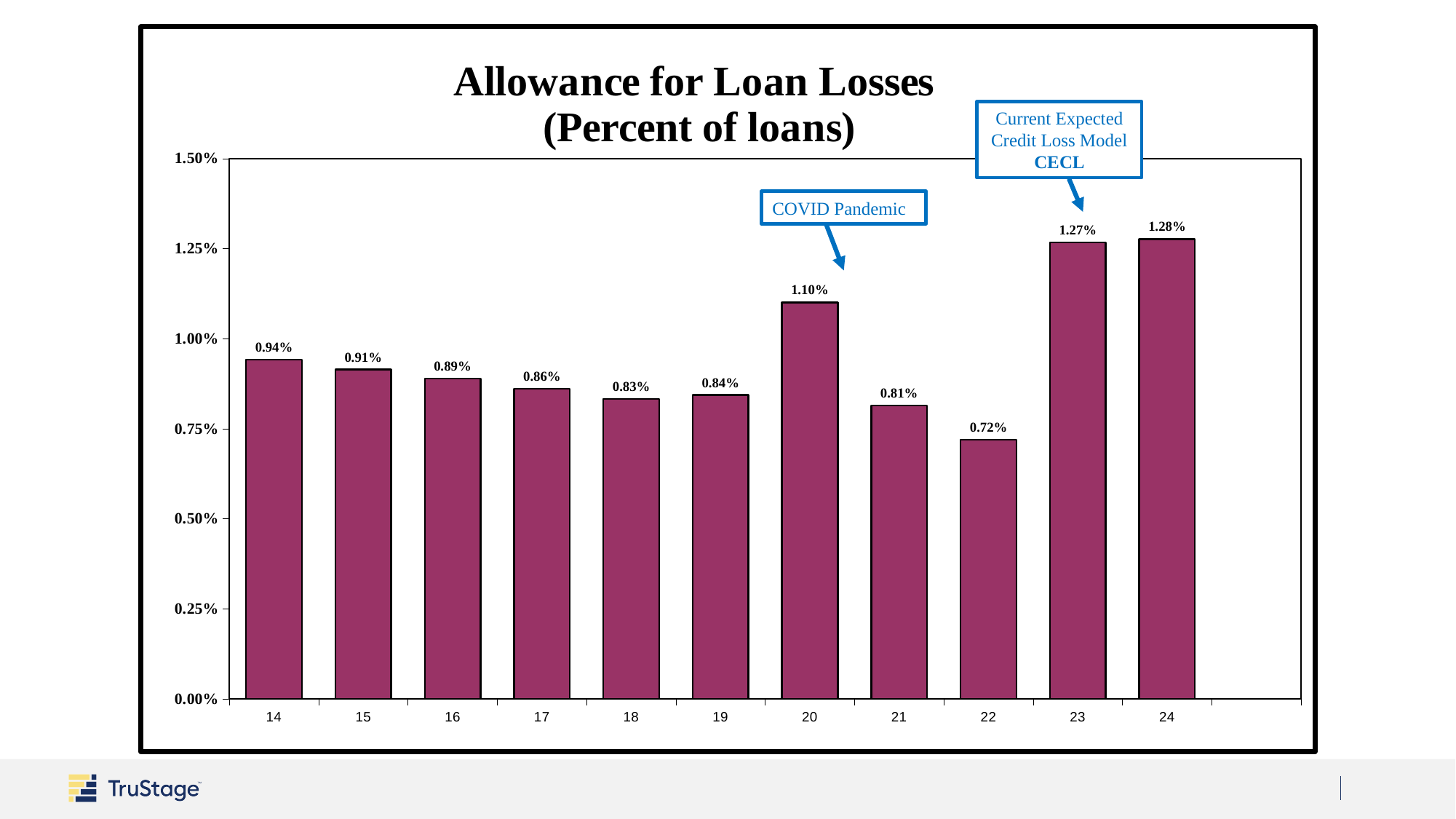
Do the values rise or fall from 14 to 18? Fall Which event does the callout above the bar for 20 label? COVID Pandemic Which year has the highest allowance for loan losses? 24 Is the value for 19 greater or less than 1.00%? less How many years are shown on the x axis? 11 What is the allowance for loan losses in 14? 0.94% Which year has the lowest allowance for loan losses? 22 What is the allowance for loan losses in 22? 0.72% Which year has a higher allowance for loan losses, 20 or 21? 20 What is the difference between the allowance for loan losses in 23 and in 22? 0.55% What is the allowance for loan losses in 20? 1.10% What kind of chart is this? Bar chart